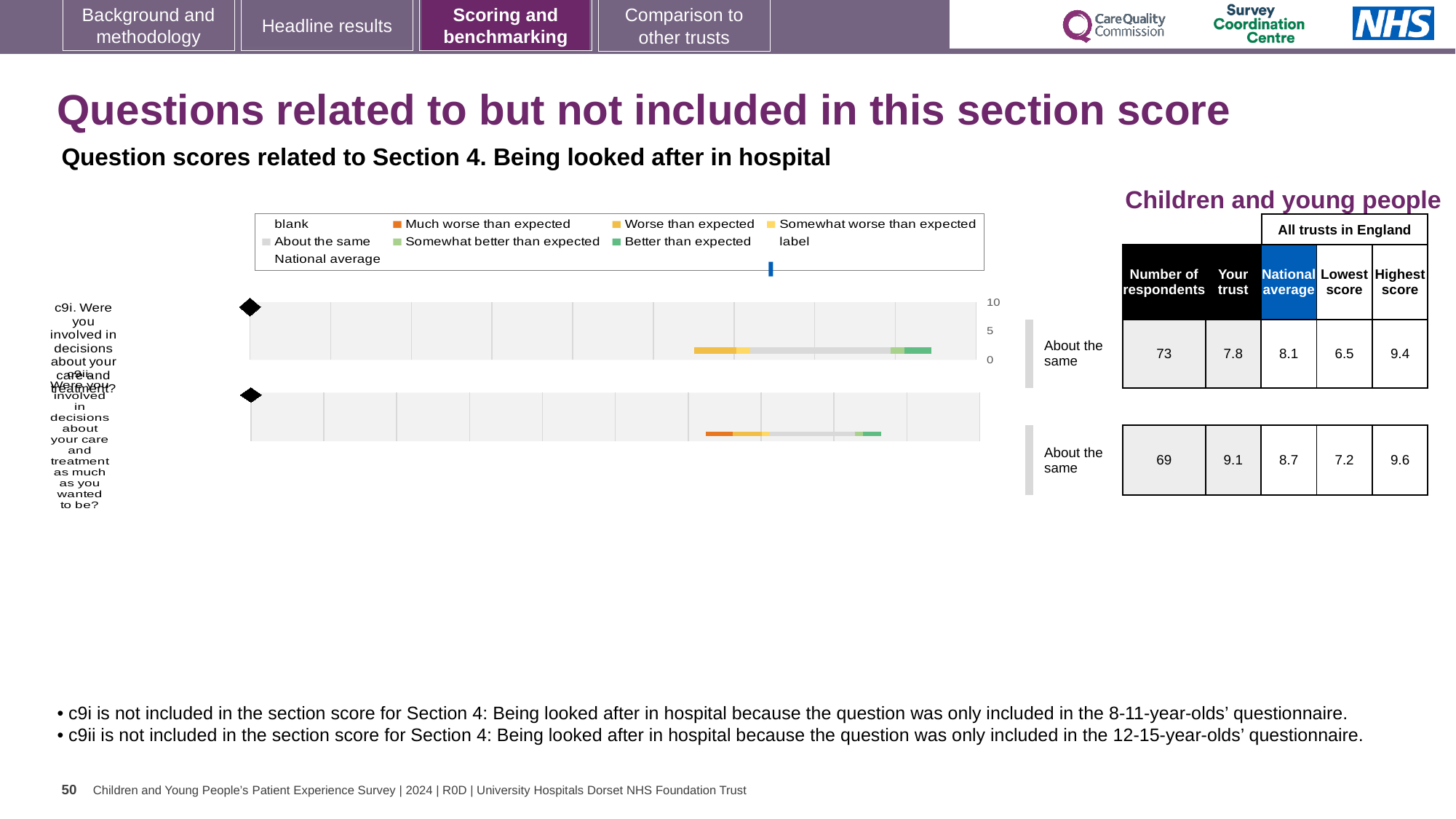
In the table next to the charts, what is the national average for c9ii? 8.7 In the table next to the charts, how many respondents answered c9i? 73 What colour represents 'Much worse than expected' in the chart legend? orange In the table, what is the difference between the highest score and the lowest score for c9i? 2.9 Which benchmark category is shown for question c9i? About the same Which question has the higher 'Your trust' score in the table, c9i or c9ii? c9ii In the table next to the charts, what is the 'Your trust' score for c9i? 7.8 How many charts are shown on the slide? 2 What is the highest value shown on the chart axis? 10 What kind of chart is used to show the question scores for c9i and c9ii? bar chart Which benchmark category is shown for question c9ii? About the same How many entries does the chart legend list? 9